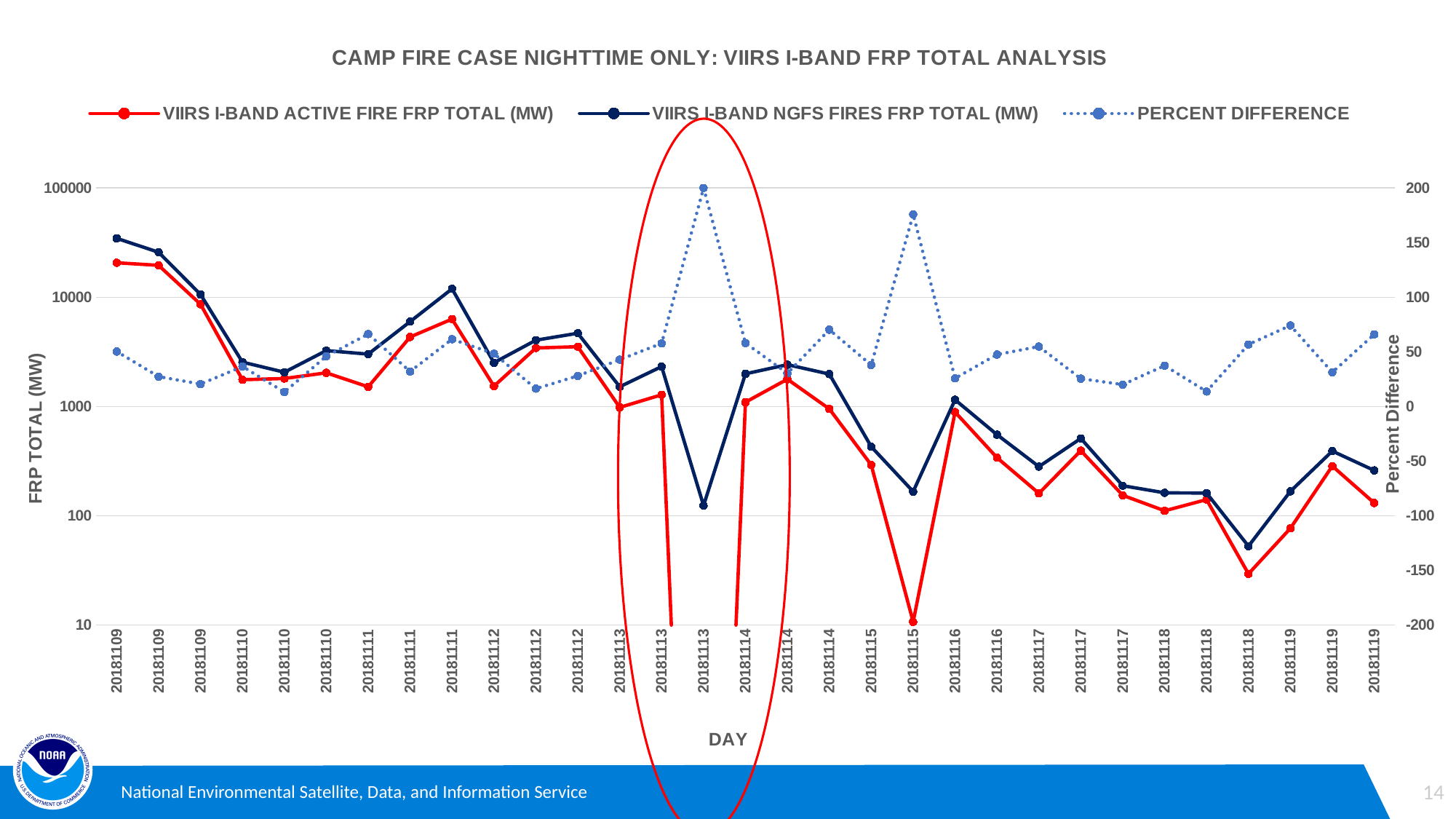
Overall, does the VIIRS I-BAND NGFS FIRES FRP TOTAL (MW) series rise or fall from 20181109 to 20181119? fall What kind of chart is shown on the slide? Line chart At the first point on the x axis (20181109), which series is higher: VIIRS I-BAND ACTIVE FIRE FRP TOTAL (MW) or VIIRS I-BAND NGFS FIRES FRP TOTAL (MW)? VIIRS I-BAND NGFS FIRES FRP TOTAL (MW) What is the title of the chart? CAMP FIRE CASE NIGHTTIME ONLY: VIIRS I-BAND FRP TOTAL ANALYSIS Is the lowest value of the VIIRS I-BAND ACTIVE FIRE FRP TOTAL (MW) series greater or less than 100? less On which day does the PERCENT DIFFERENCE series reach its highest value? 20181113 Is the lowest value of the VIIRS I-BAND NGFS FIRES FRP TOTAL (MW) series greater or less than 1000? less What is the label of the left vertical axis? FRP TOTAL (MW) On which day does the VIIRS I-BAND ACTIVE FIRE FRP TOTAL (MW) series reach its lowest value? 20181113 How many series does the legend list? 3 Is the highest value of the PERCENT DIFFERENCE series greater or less than 150? greater How many distinct days are labelled on the x axis? 11